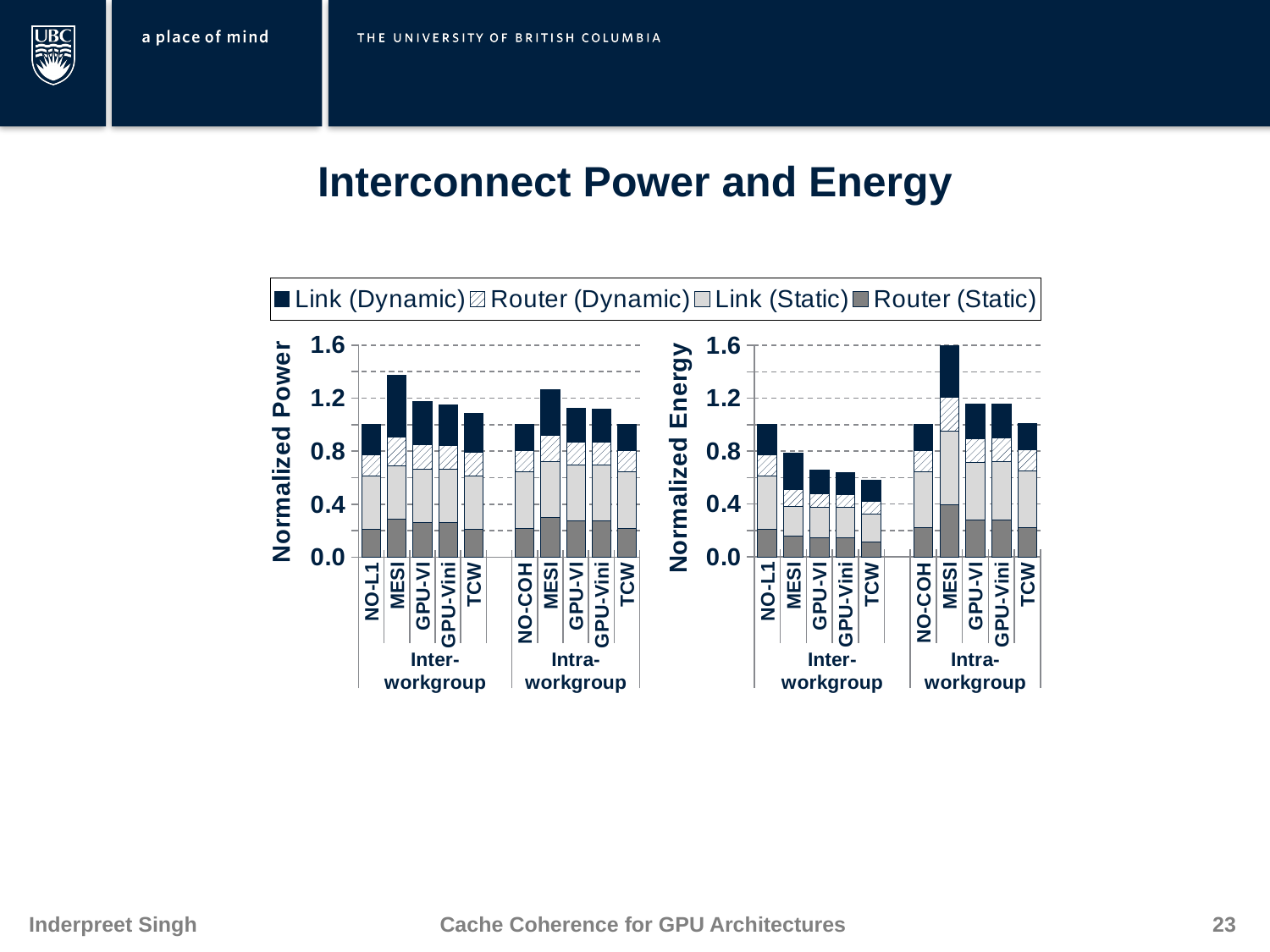
In the Normalized Energy chart on the right, is the total for TCW in the Inter-workgroup group greater or less than 0.8? less What kind of chart is the Normalized Power chart on the left? stacked bar chart How many series does the legend list? 4 In the Normalized Energy chart on the right, do the Inter-workgroup bars rise or fall from NO-L1 to TCW? fall What is the y-axis label of the chart on the right? Normalized Energy In the Normalized Energy chart on the right, which bar is the lowest? TCW (Inter-workgroup) How many bars are plotted in the Normalized Energy chart on the right? 10 In the Normalized Energy chart on the right, which bar is the highest? MESI (Intra-workgroup) In the Normalized Energy chart on the right, which MESI bar is taller: Inter-workgroup or Intra-workgroup? Intra-workgroup In the Normalized Energy chart on the right, is the total for MESI in the Intra-workgroup group greater or less than 1.2? greater In the Normalized Power chart on the left, which bar is the highest? MESI (Inter-workgroup) In the Normalized Power chart on the left, is the total for MESI in the Inter-workgroup group greater or less than 1.2? greater